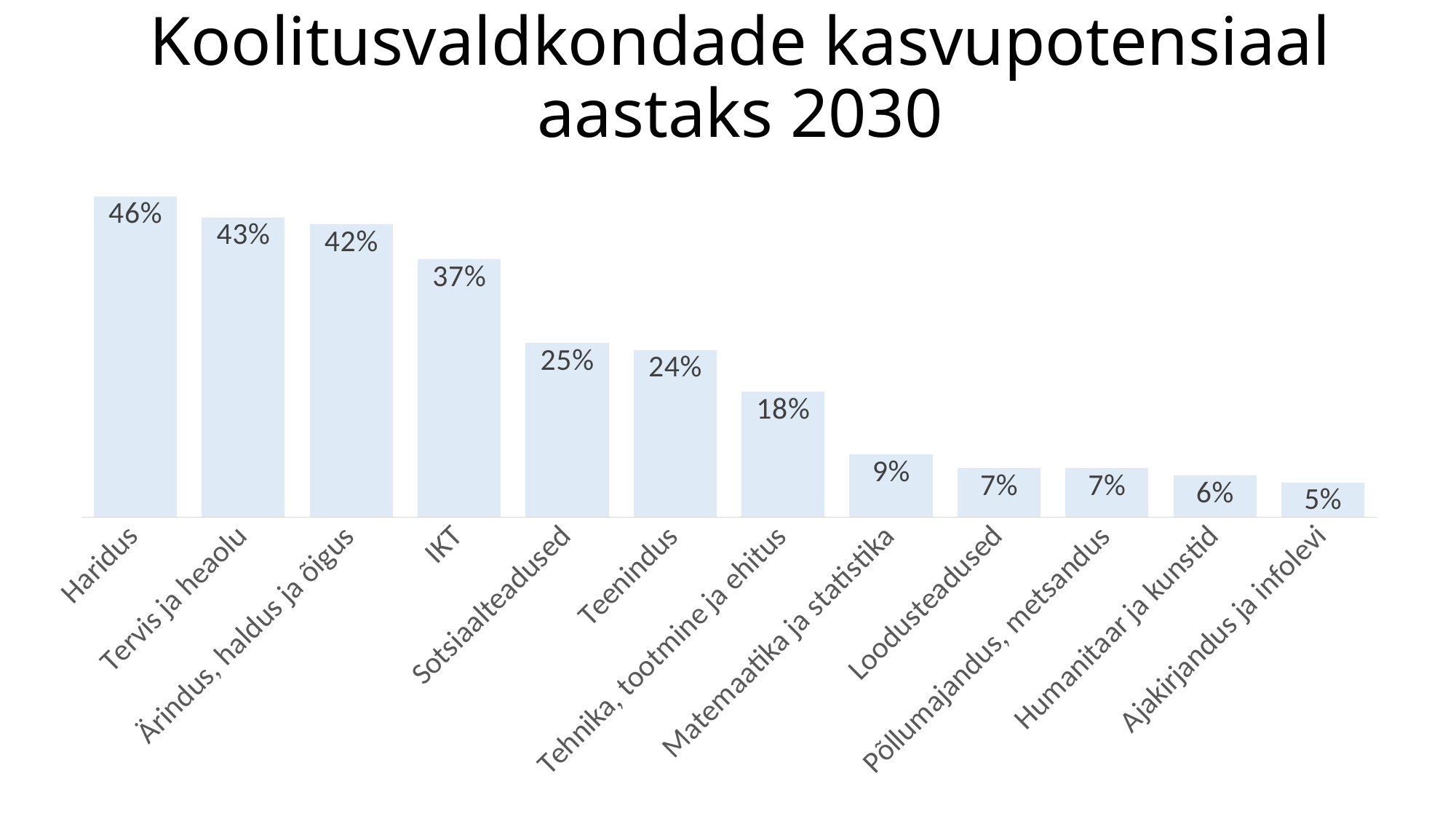
What is the value for IKT? 37% What is the difference between the values for Sotsiaalteadused and Matemaatika ja statistika? 16% Which category has the lowest value? Ajakirjandus ja infolevi What is the title of the chart? Koolitusvaldkondade kasvupotensiaal aastaks 2030 What kind of chart is this? Bar chart What is the difference between the values for Haridus and Tervis ja heaolu? 3% What is the value for Ajakirjandus ja infolevi? 5% What is the value for Tehnika, tootmine ja ehitus? 18% How many categories are shown in the chart? 12 Which is larger, the value for Teenindus or the value for Loodusteadused? Teenindus What is the value for Haridus? 46% Which category has the highest value? Haridus